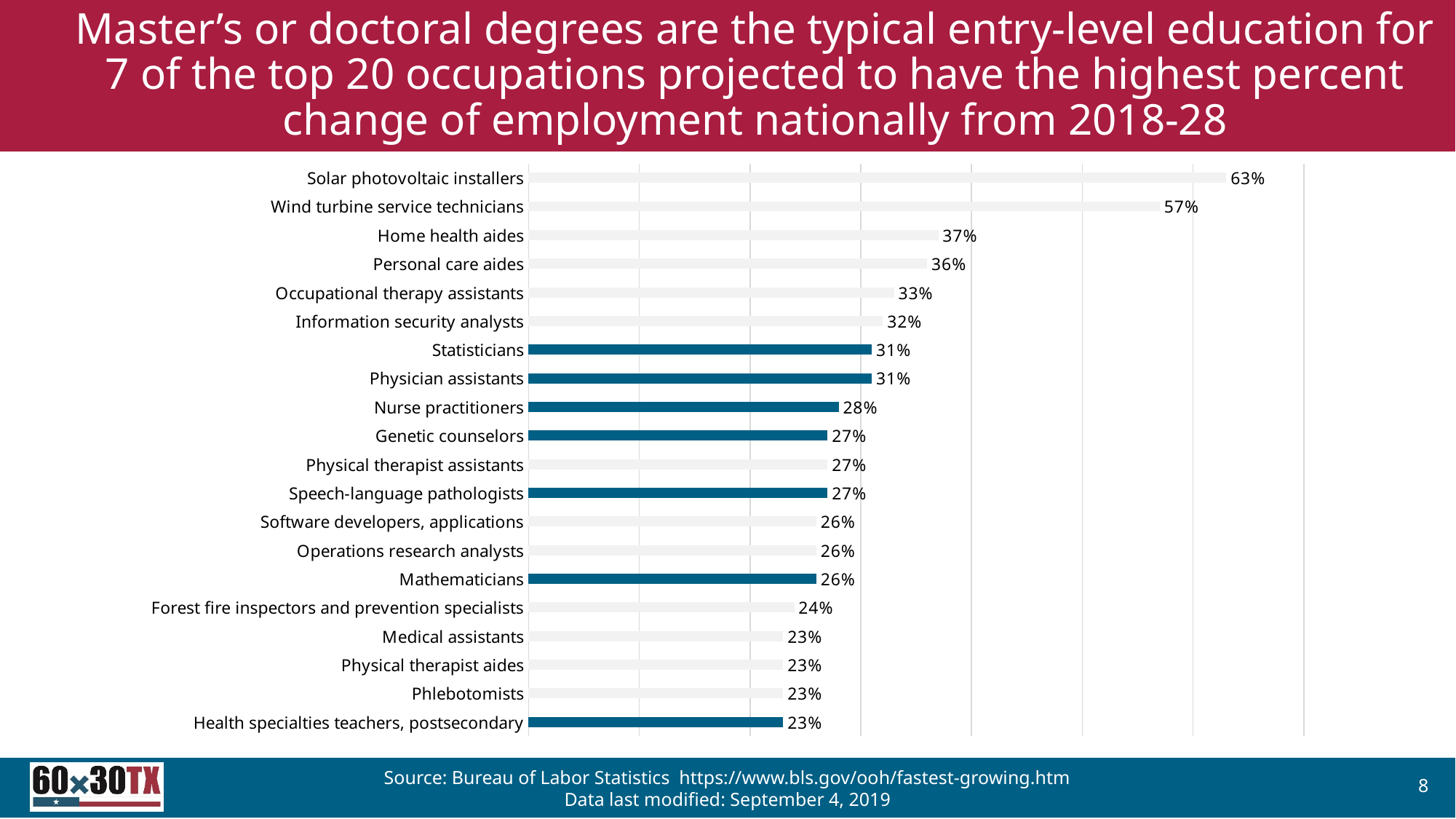
What kind of chart is shown on the slide? Bar chart How many bars in the chart are highlighted in dark blue? 7 What is the projected percent change in employment for Nurse practitioners? 28% What is the source of the data shown in the chart? Bureau of Labor Statistics Which has a larger projected percent change, Information security analysts or Mathematicians? Information security analysts What is the projected percent change in employment for Forest fire inspectors and prevention specialists? 24% Which has a larger projected percent change, Wind turbine service technicians or Personal care aides? Wind turbine service technicians How many occupations are shown in the chart? 20 Which occupation has the highest projected percent change in employment? Solar photovoltaic installers What is the projected percent change in employment for Solar photovoltaic installers? 63% What is the difference in projected percent change between Home health aides and Statisticians? 6% What is the difference in projected percent change between Solar photovoltaic installers and Wind turbine service technicians? 6%